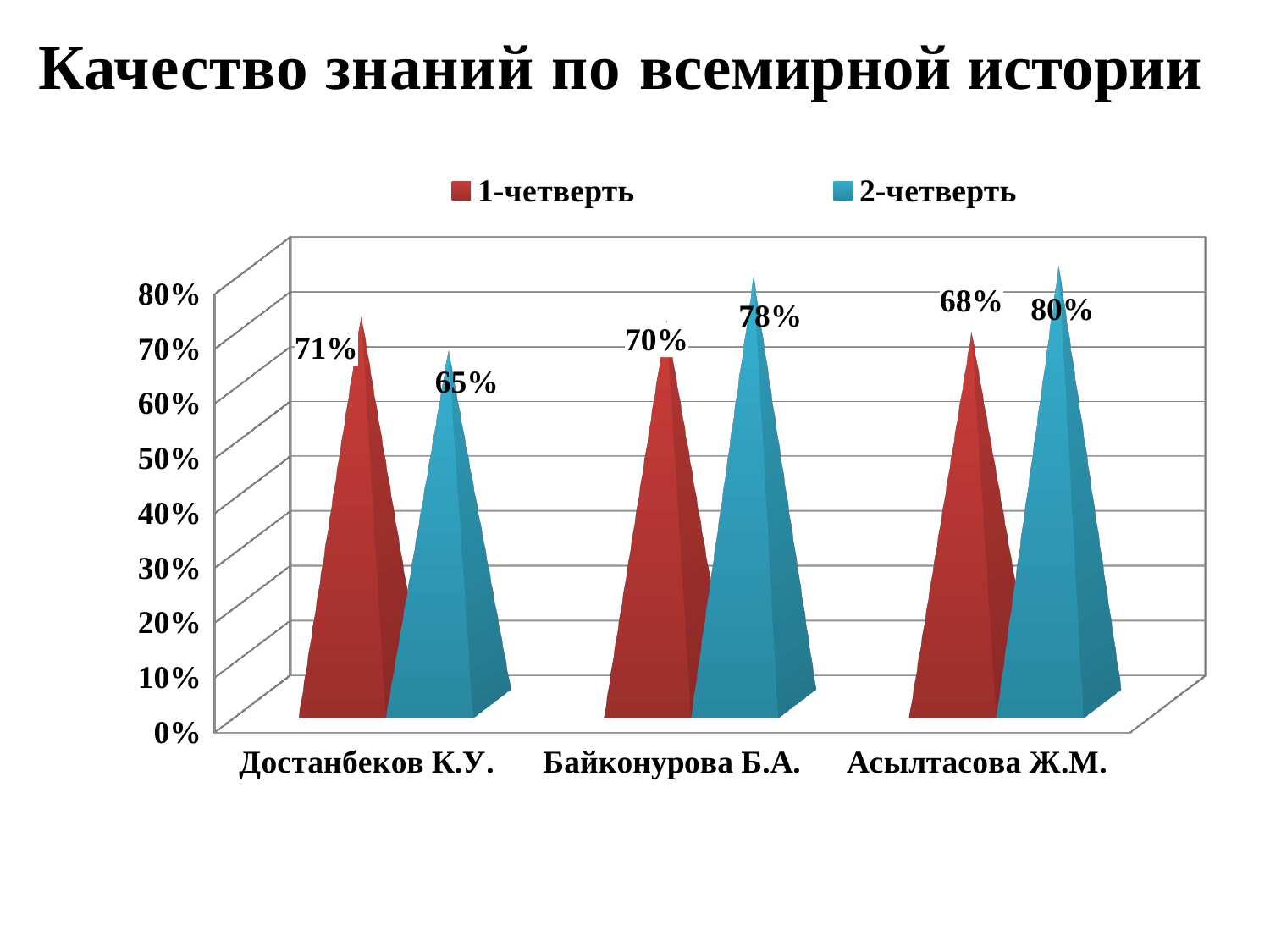
What is the value for Байконурова Б.А. in the 2-четверть series? 78% How many teachers (categories) are shown on the x axis? 3 How many series does the legend list? 2 Which teacher has the highest value in the 2-четверть series? Асылтасова Ж.М. What is the title of the chart? Качество знаний по всемирной истории What is the difference between the 1-четверть and 2-четверть values for Достанбеков К.У.? 6% What is the value for Достанбеков К.У. in the 1-четверть series? 71% Which is larger for Байконурова Б.А.: the 1-четверть value or the 2-четверть value? 2-четверть Which teacher has the lowest value in the 2-четверть series? Достанбеков К.У. What is the difference between the 2-четверть and 1-четверть values for Асылтасова Ж.М.? 12% What is the value for Асылтасова Ж.М. in the 1-четверть series? 68% What kind of chart is shown on the slide? Bar chart